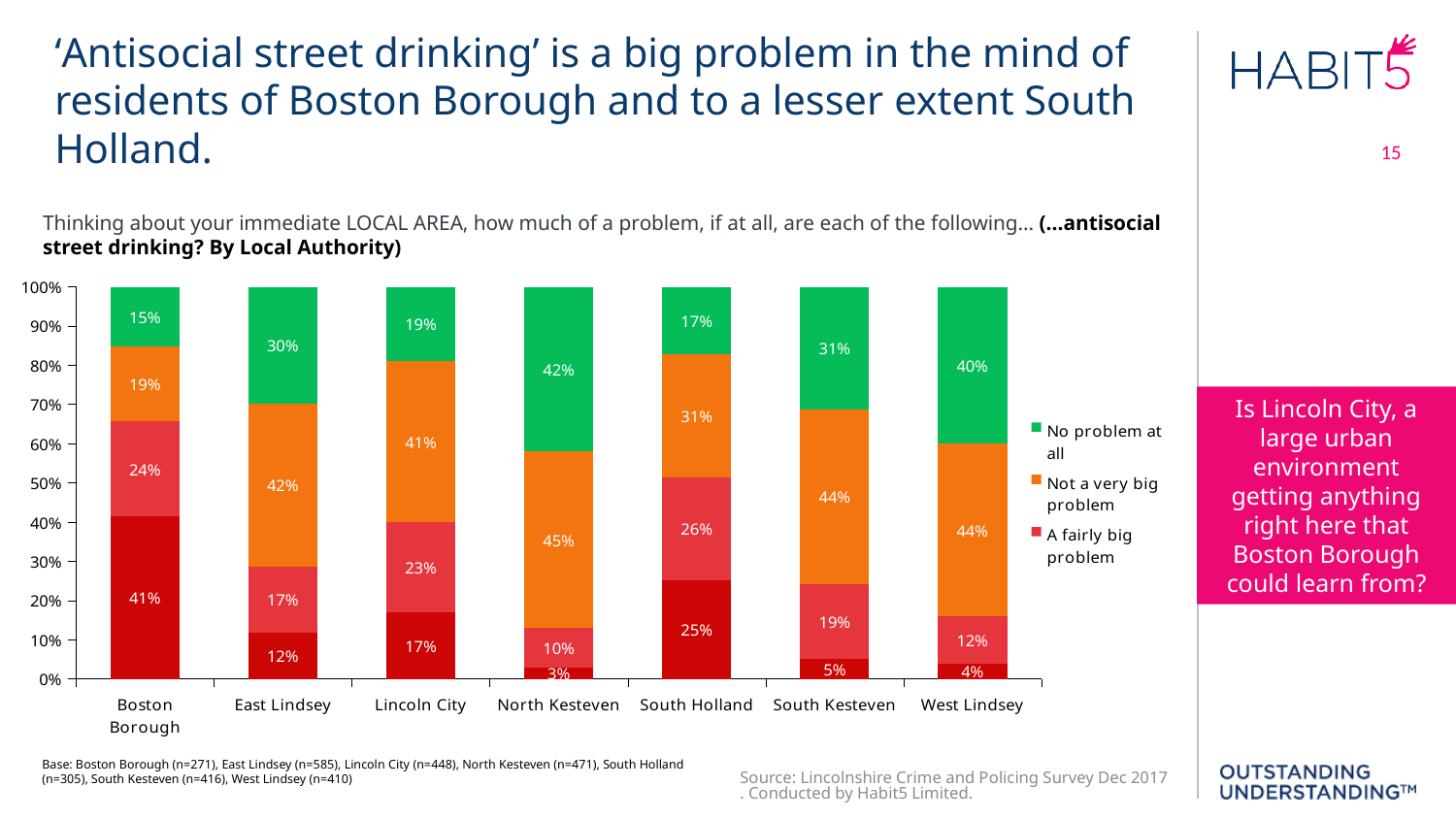
What kind of chart is shown on the slide? Stacked bar chart How many series does the chart's legend list? 3 What colour represents 'No problem at all' in the chart legend? Green How many local authorities are shown on the x axis of the chart? 7 What is the 'A fairly big problem' value for South Holland? 26% Which local authority has the lowest 'No problem at all' percentage? Boston Borough What percentage of North Kesteven residents said antisocial street drinking is 'No problem at all'? 42% Which local authority has the lowest 'A fairly big problem' percentage? North Kesteven What is the difference in percentage points between the 'Not a very big problem' values for East Lindsey and Boston Borough? 23 percentage points Which local authority has the highest 'No problem at all' percentage? North Kesteven Which has a larger 'A fairly big problem' value, South Holland or East Lindsey? South Holland What is the 'Not a very big problem' value for Lincoln City? 41%